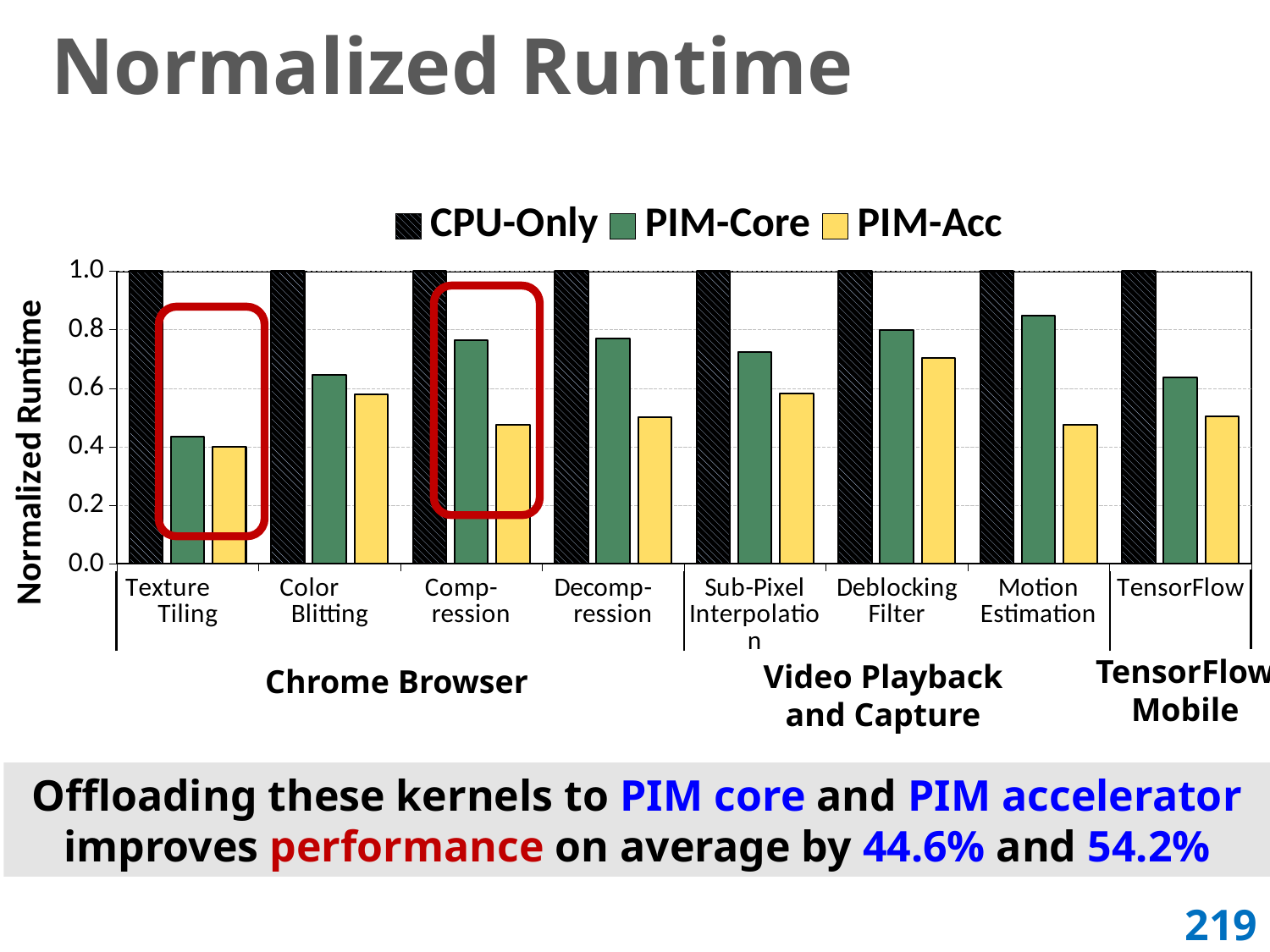
Which category has the highest PIM-Acc normalized runtime? Deblocking Filter For Motion Estimation, which is larger: the PIM-Core value or the PIM-Acc value? PIM-Core How many kernel categories are plotted along the x axis? 8 What type of chart is shown on the slide? bar chart How many series does the legend list? 3 Which category has the highest PIM-Core normalized runtime? Motion Estimation Is the PIM-Acc value for Deblocking Filter greater or less than 0.6? greater What is the label on the y axis of the chart? Normalized Runtime Which is larger: the PIM-Acc value for Texture Tiling or the PIM-Acc value for Deblocking Filter? Deblocking Filter What is the CPU-Only normalized runtime for Texture Tiling? 1.0 Which category has the lowest PIM-Acc normalized runtime? Texture Tiling Is the PIM-Core value for Texture Tiling greater or less than 0.6? less